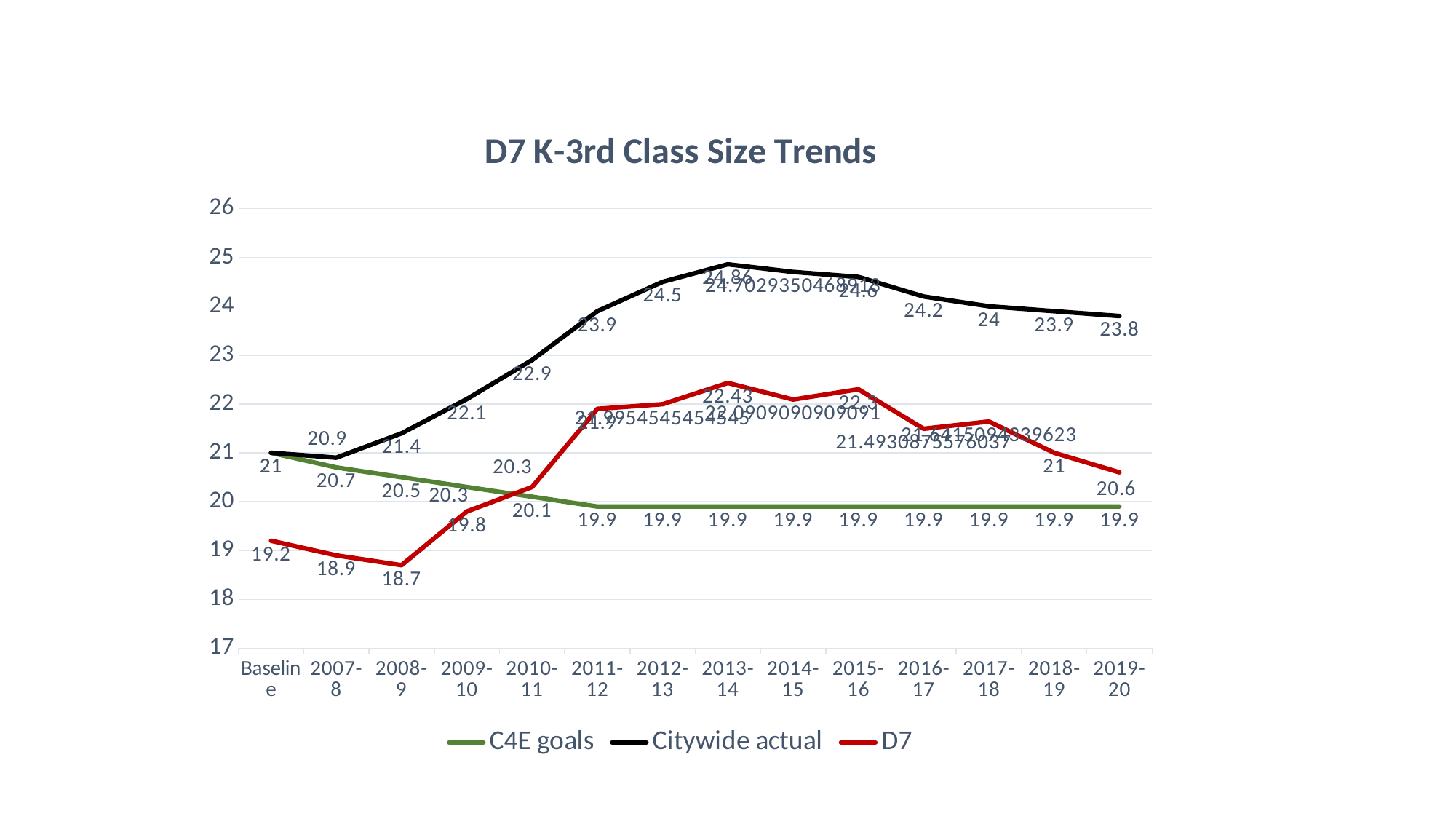
How many categories are shown along the x axis? 14 In which year is the Citywide actual value highest? 2013-14 What is the D7 value for 2008-9? 18.7 In which year is the D7 value lowest? 2008-9 Do the C4E goals values rise or fall from Baseline to 2011-12? fall In 2010-11, which is larger: the D7 value or the C4E goals value? D7 What is the C4E goals value for 2019-20? 19.9 What is the difference between the Citywide actual value and the D7 value in 2019-20? 3.2 What kind of chart is shown on the slide? line chart What is the Citywide actual value for 2013-14? 24.86 How many series does the legend list? 3 Is the Citywide actual value for 2012-13 greater or less than 24? greater